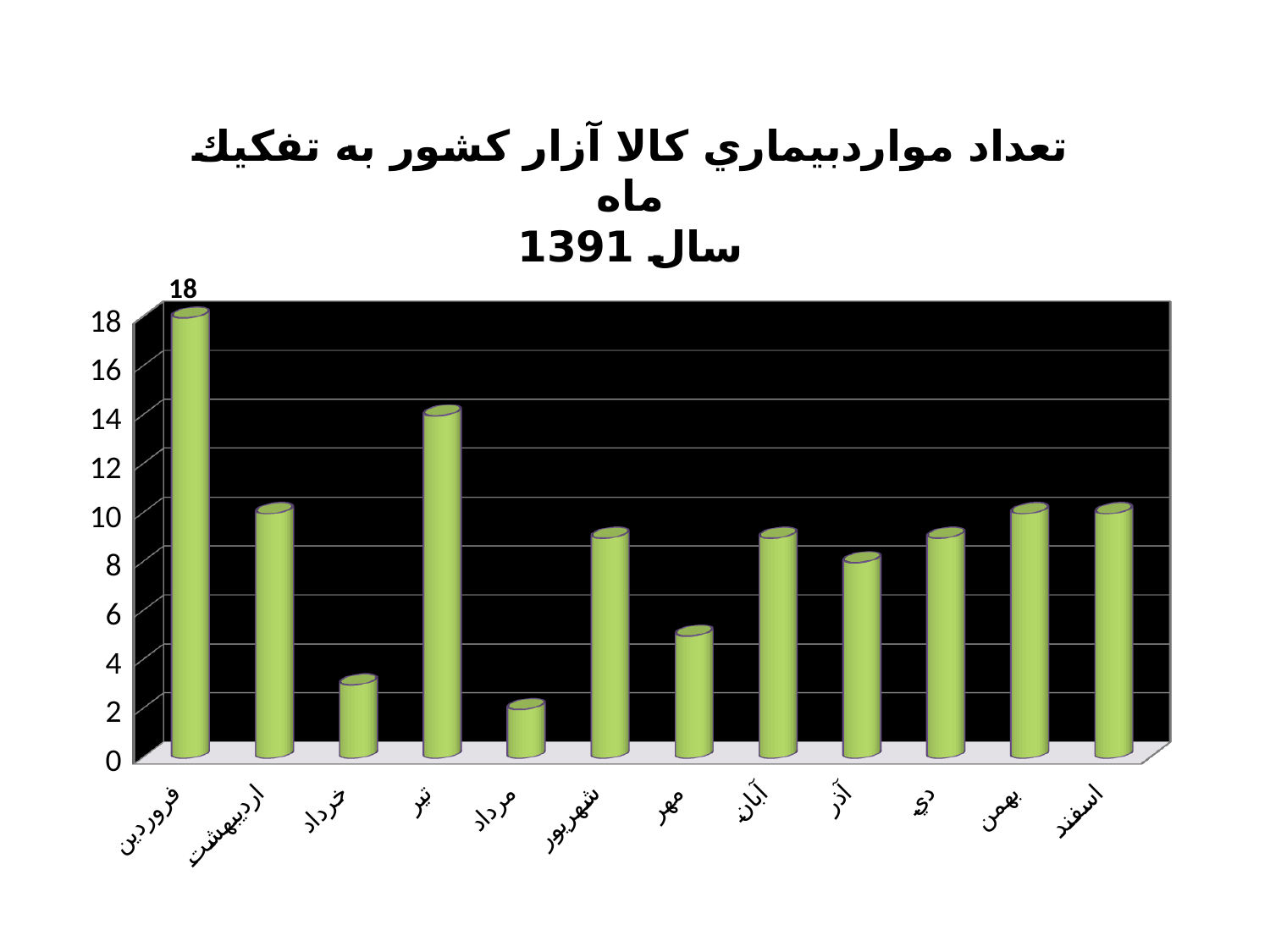
Which month has the highest value? فروردین Which is larger, the value for خرداد or the value for مهر? مهر What is the value for فروردین? 18 Which year is named in the chart title? 1391 Is the value for مهر greater or less than 6? less Is the value for خرداد greater or less than 4? less Which is larger, the value for تیر or the value for اردیبهشت? تیر Is the value for تیر greater or less than 12? greater Which month has the lowest value? مرداد How many months are shown on the x axis? 12 What kind of chart is this? bar chart